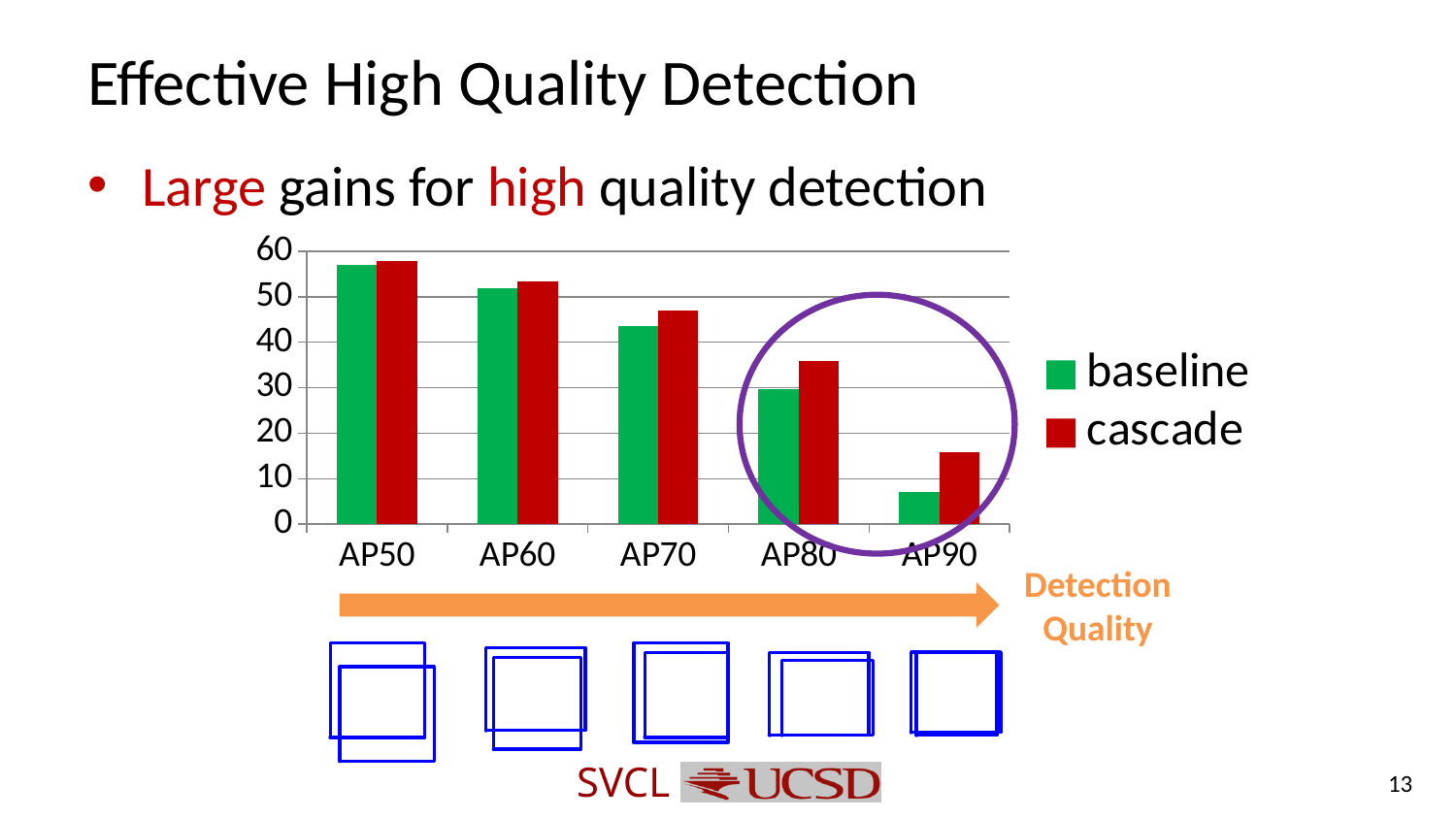
What kind of chart is shown on the slide? bar chart For which category is the cascade value highest? AP50 Is the cascade value for AP90 greater or less than 20? less Which colour represents the cascade series in the chart? red Is the cascade value for AP80 greater or less than 30? greater At AP80, which is larger, the baseline value or the cascade value? cascade For which category is the baseline value lowest? AP90 Is the baseline value for AP50 greater or less than 50? greater How many categories are shown on the x axis of the chart? 5 Which series are listed in the chart's legend? baseline and cascade How many series does the chart's legend list? 2